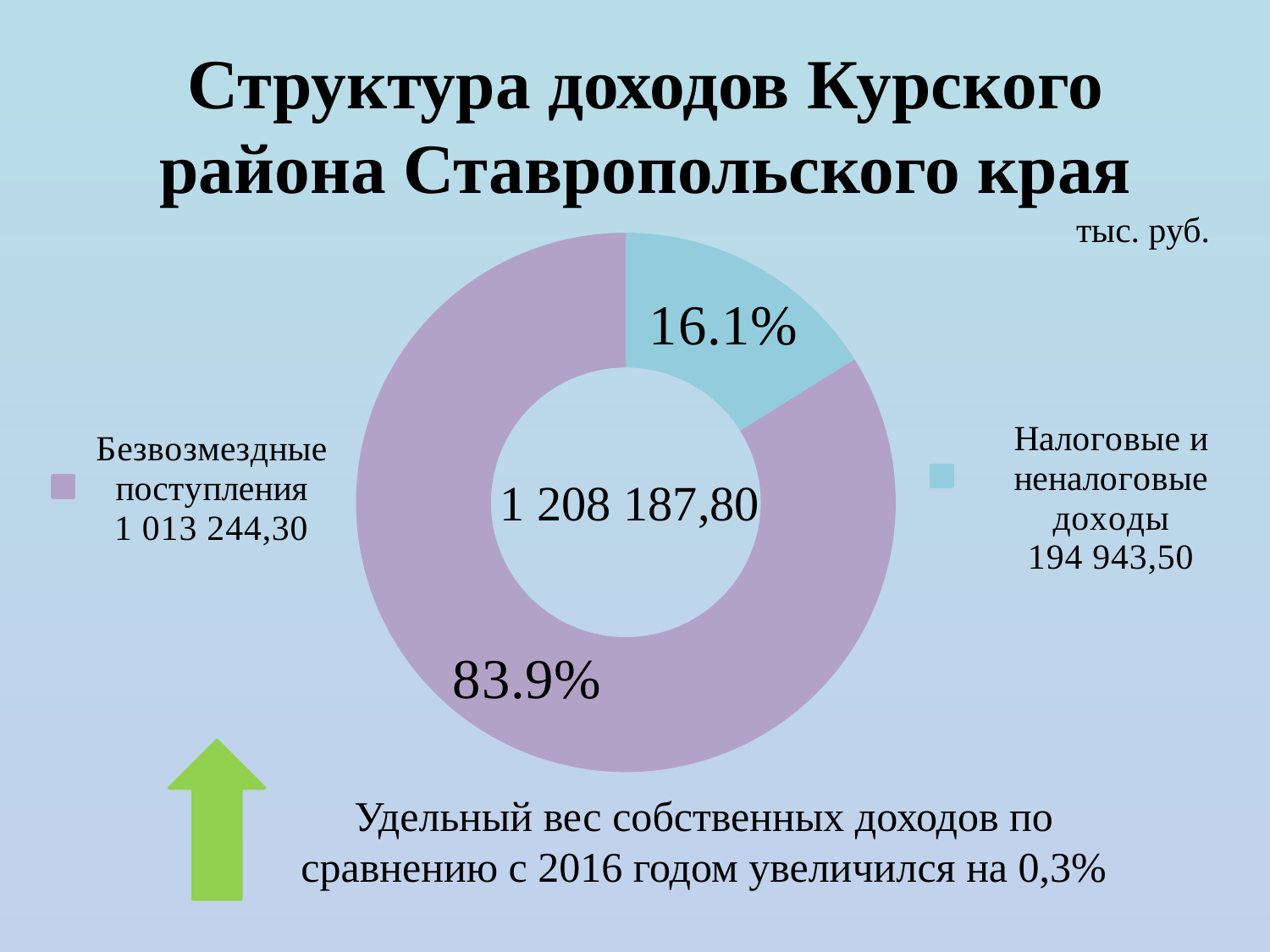
What is the value for Налоговые и неналоговые доходы? 194 943,50 Which category has the smallest value? Налоговые и неналоговые доходы What is the difference between the values for Безвозмездные поступления and Налоговые и неналоговые доходы? 818 300,80 Which is larger: Безвозмездные поступления or Налоговые и неналоговые доходы? Безвозмездные поступления What total value is shown in the centre of the chart? 1 208 187,80 Which category has the largest value? Безвозмездные поступления What unit is indicated for the chart values? тыс. руб. What kind of chart is shown on the slide? Doughnut chart How many categories does the chart show? 2 What share of the chart does Налоговые и неналоговые доходы represent? 16.1% What is the value for Безвозмездные поступления? 1 013 244,30 What share of the chart does Безвозмездные поступления represent? 83.9%